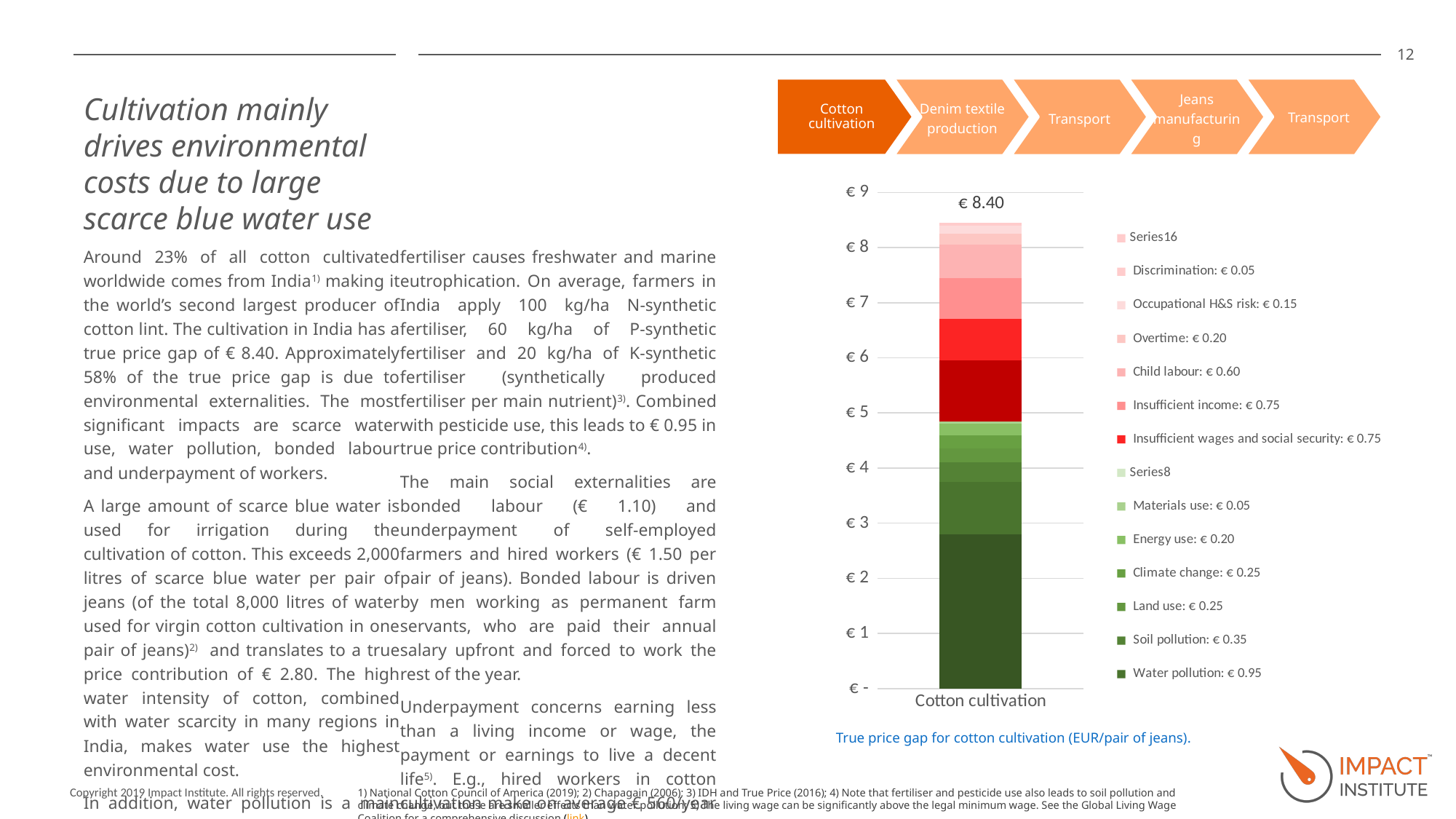
What kind of chart is shown on the slide? stacked bar chart According to the legend, what is the value for Child labour? € 0.60 Which is larger, the value for Child labour or the value for Soil pollution? Child labour What is the total true price gap shown on top of the Cotton cultivation bar? € 8.40 Which legend entry has the highest value? Water pollution How many series does the legend list? 14 According to the legend, what is the value for Water pollution? € 0.95 Is the total height of the Cotton cultivation bar greater or less than € 8? greater According to the legend, what is the value for Occupational H&S risk? € 0.15 According to the legend, what is the value for Insufficient income? € 0.75 How many categories are shown on the x axis of the chart? 1 What is the difference between the values for Water pollution and Child labour? € 0.35